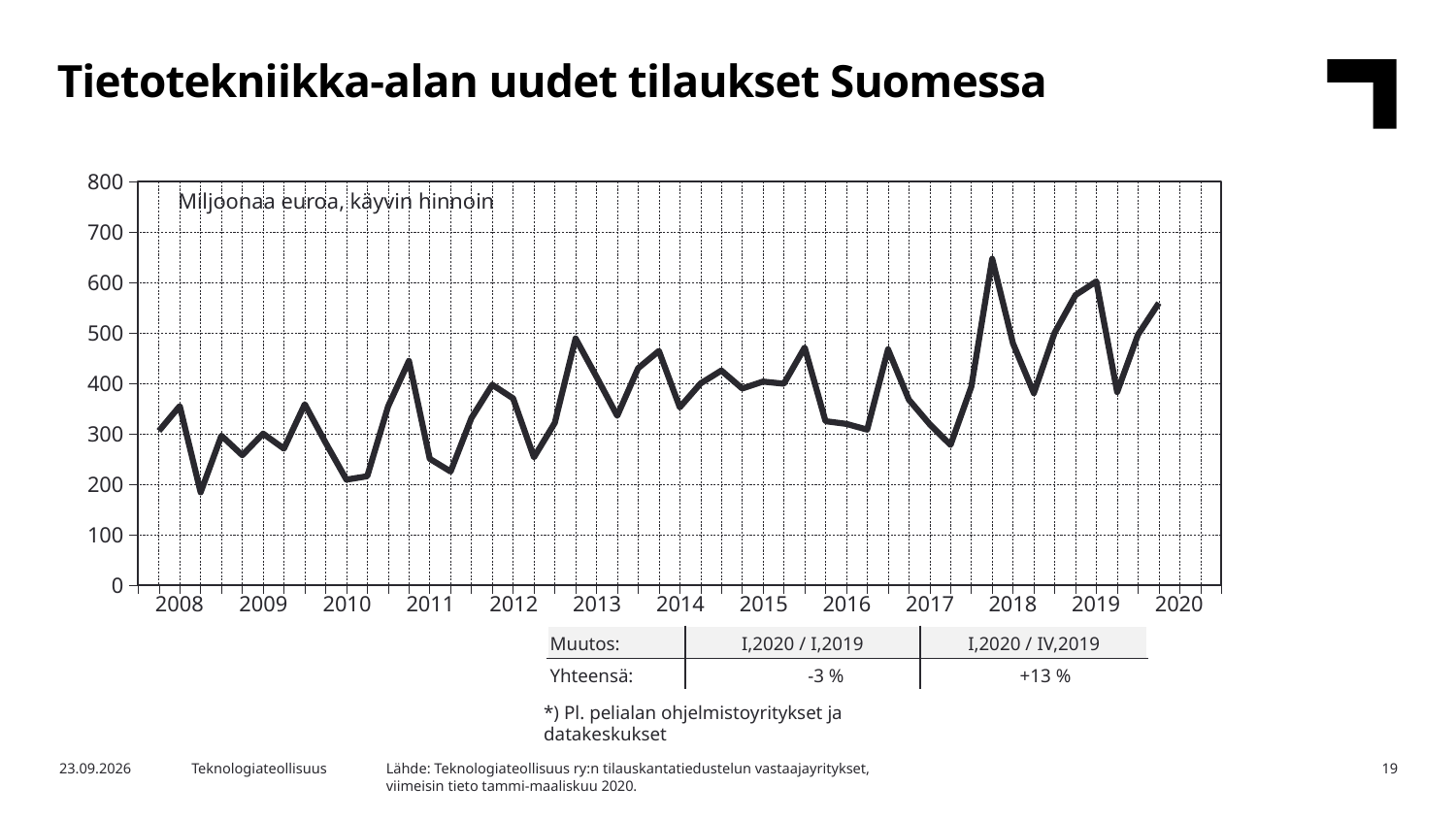
Is the highest peak of the line, in 2018, greater or less than 600? greater What kind of chart is shown on the slide? line chart In which year does the line reach its highest peak? 2018 What is the change shown in the table for I,2020 / I,2019? -3 % Is the peak in 2018 higher or lower than the peak in 2013? higher Is the lowest point of the line, in 2008, greater or less than 200? less What is the title of the chart on the slide? Tietotekniikka-alan uudet tilaukset Suomessa Overall, do the values rise or fall from 2008 to 2020? rise In which year does the line reach its lowest point? 2008 Is the last plotted value, at the start of 2020, greater or less than 500? greater In what unit are the values on the chart expressed, according to the label inside the plot area? Miljoonaa euroa, käyvin hinnoin How many year labels are shown on the x axis of the chart? 13